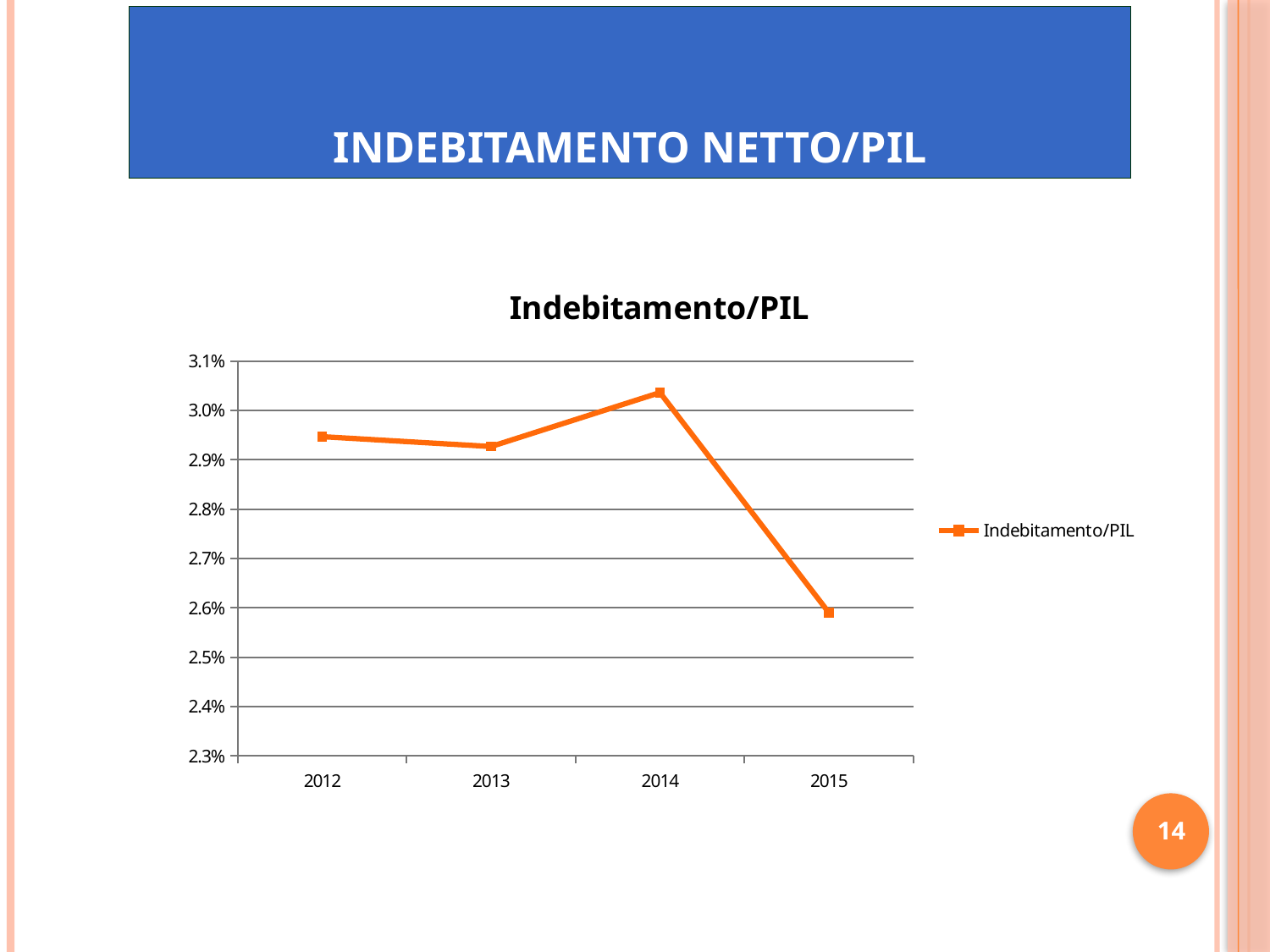
How many series does the legend list? 1 How many years are plotted on the x axis? 4 What is the title of the chart? Indebitamento/PIL Is the value for 2014 greater or less than 2.9%? greater Does the Indebitamento/PIL value rise or fall from 2014 to 2015? fall Which year has a larger value, 2014 or 2015? 2014 Is the value for 2015 greater or less than 2.7%? less Which year has the lowest Indebitamento/PIL value? 2015 Is the value for 2012 greater or less than 2.9%? greater Which year has the highest Indebitamento/PIL value? 2014 What kind of chart is shown on the slide? line chart